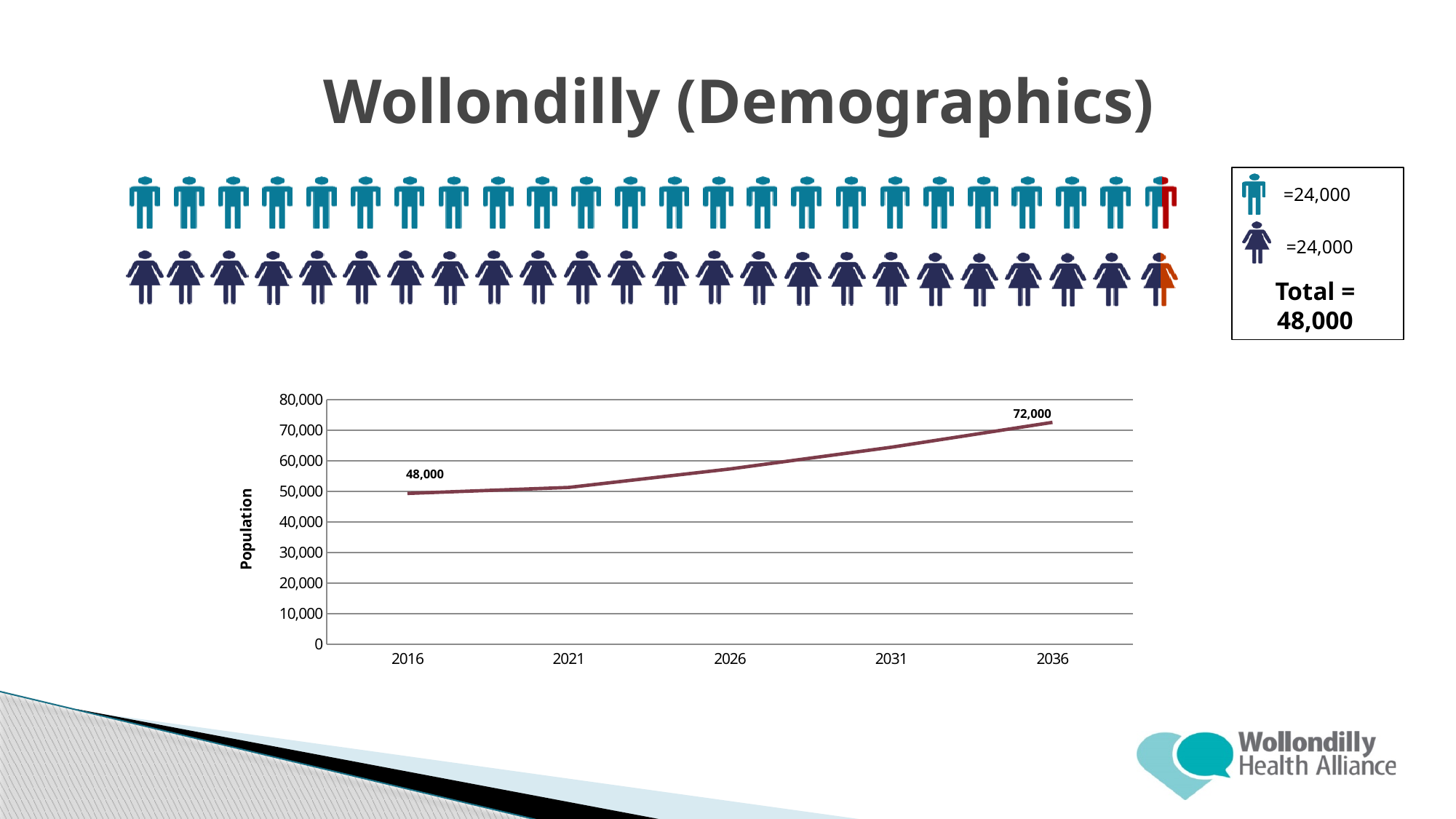
Is the value for 2021 greater or less than 60,000? less What type of chart is shown on the slide? line chart What is the population value shown for 2036? 72,000 What is the population value shown for 2016? 48,000 Does the population rise or fall from 2016 to 2036? rise Which year has the lowest population value on the chart? 2016 How many years are marked on the x axis of the chart? 5 What is the difference between the population values for 2036 and 2016? 24,000 What is the label on the y axis of the chart? Population Is the value for 2031 greater or less than 60,000? greater Is the value for 2026 greater or less than 50,000? greater Which year has the highest population value on the chart? 2036